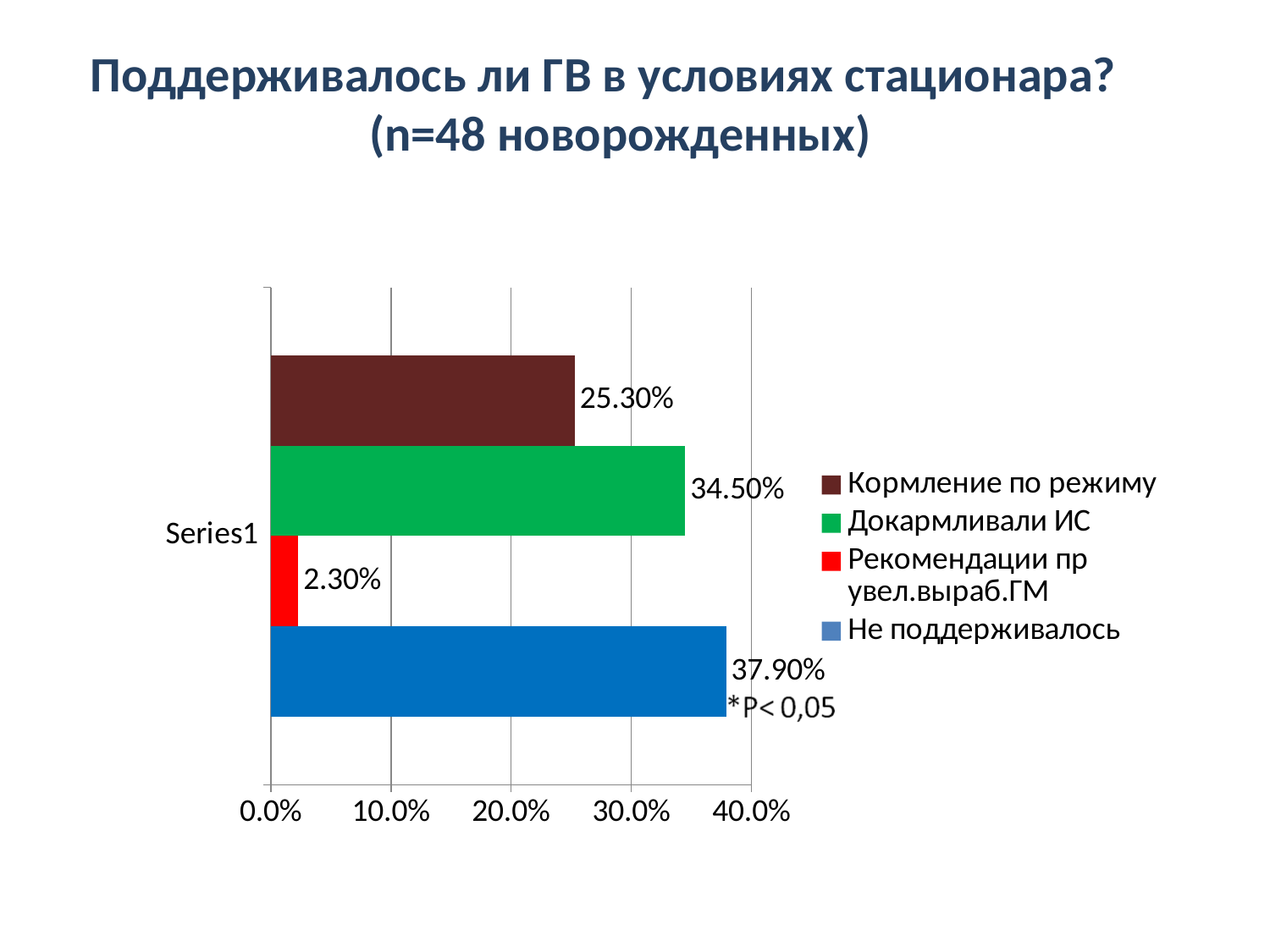
What colour is the bar for Докармливали ИС? green Which series has the lowest value? Рекомендации пр увел.выраб.ГМ What is the value for Докармливали ИС? 34.50% Which series has the highest value? Не поддерживалось What is the value for Кормление по режиму? 25.30% What is the value for Рекомендации пр увел.выраб.ГМ? 2.30% Which is larger, the value for Кормление по режиму or the value for Докармливали ИС? Докармливали ИС What is the difference between the values for Не поддерживалось and Докармливали ИС? 3.40% Is the value for Кормление по режиму greater or less than 30.0%? less What type of chart is shown on the slide? bar chart How many series does the legend list? 4 What is the value for Не поддерживалось? 37.90%